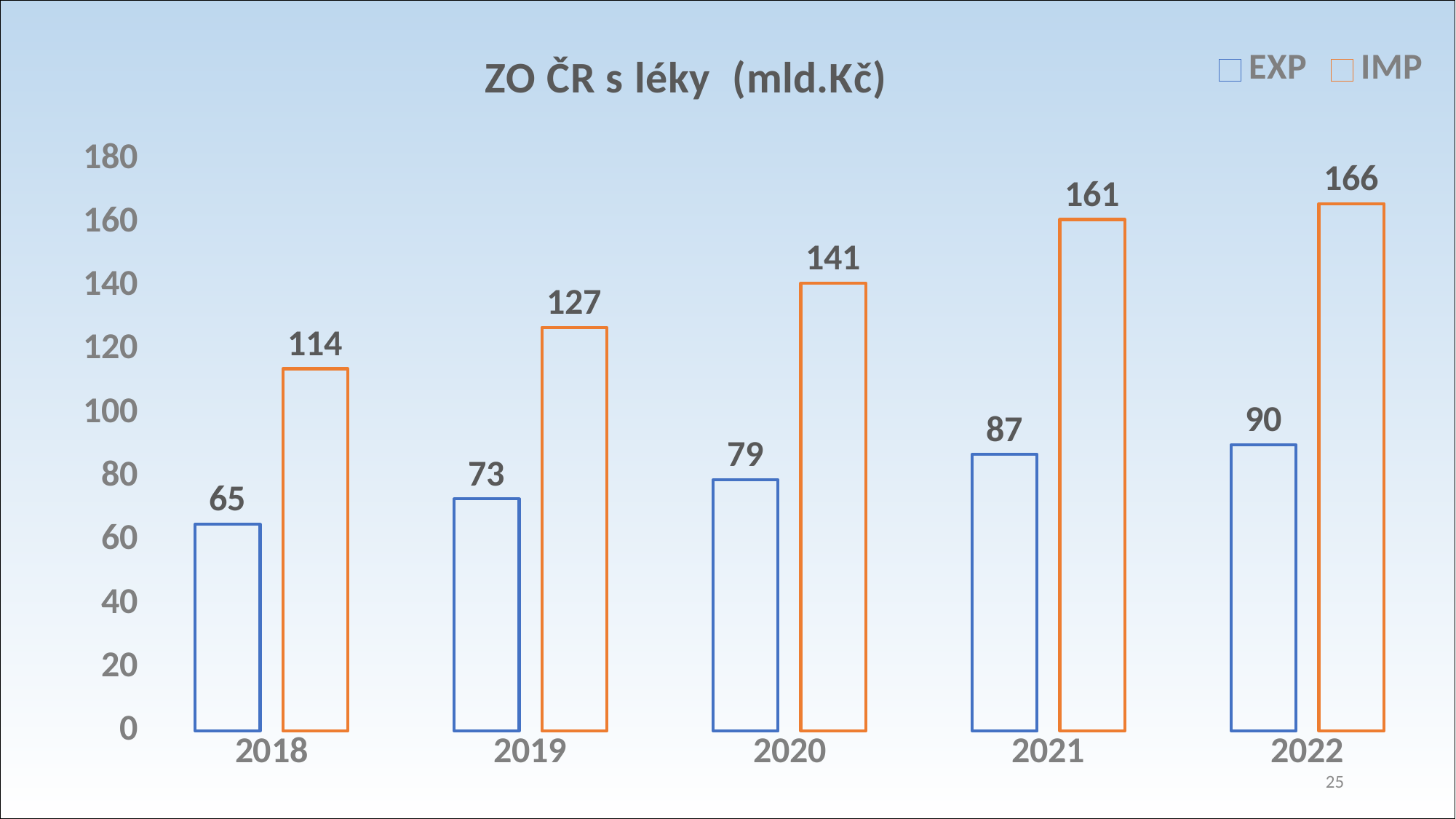
Do the EXP values rise or fall from 2018 to 2022? rise What is the difference between IMP and EXP in 2020? 62 Is the IMP value for 2020 greater or less than 120? greater How many series does the legend list? 2 What is the IMP value for 2019? 127 Which year has the highest IMP value? 2022 How many years are shown on the x axis? 5 What is the EXP value for 2018? 65 Which year has the lowest EXP value? 2018 Which is larger in 2022, EXP or IMP? IMP What is the IMP value for 2021? 161 What kind of chart is shown on the slide? bar chart